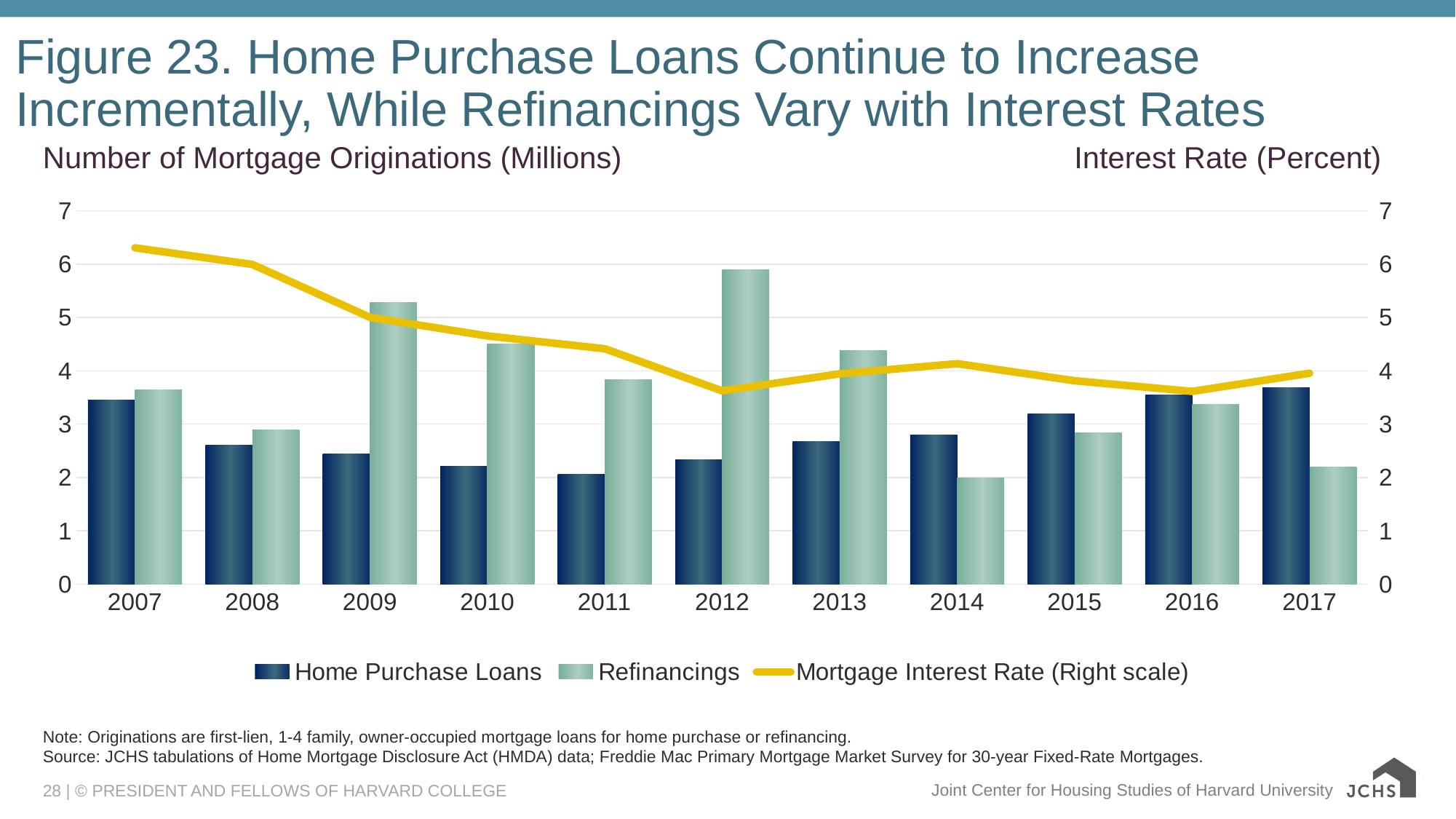
Is the value for Refinancings in 2009 greater or less than 5? greater In 2012, which is larger: Home Purchase Loans or Refinancings? Refinancings In 2017, which is larger: Home Purchase Loans or Refinancings? Home Purchase Loans Does the Mortgage Interest Rate rise or fall from 2007 to 2012? fall Which year has the highest value for Refinancings? 2012 Is the value for Home Purchase Loans in 2007 greater or less than 3? greater How many years are shown on the x axis? 11 Which year has the lowest value for Home Purchase Loans? 2011 Which year has the highest value for Home Purchase Loans? 2017 How many series does the legend list? 3 Which year has the lowest value for Refinancings? 2014 Is the Mortgage Interest Rate in 2007 greater or less than 6? greater